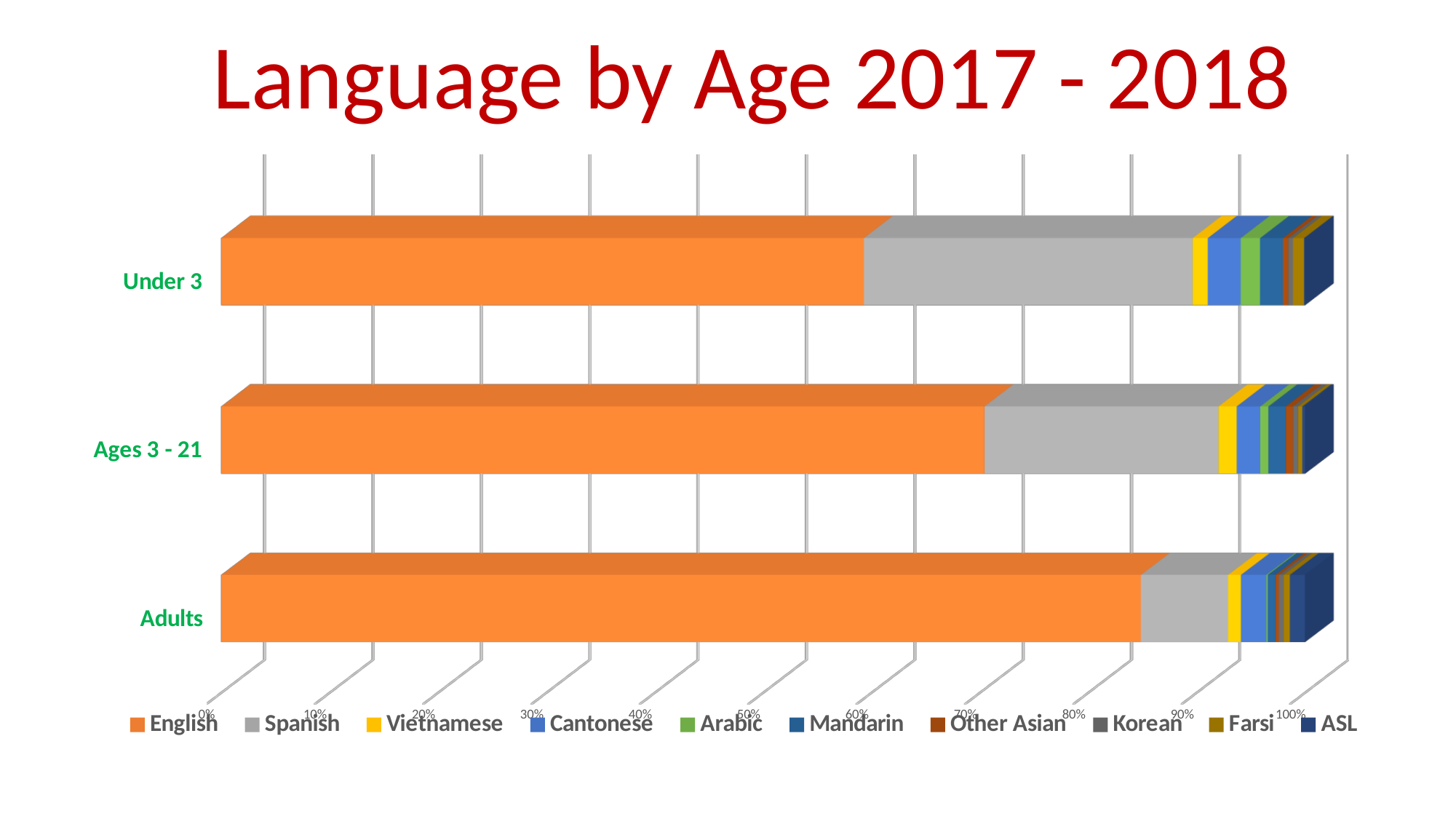
Which age group has the largest English share? Adults Is the English share for Ages 3 - 21 greater or less than 60%? greater Which age group has the smallest English share? Under 3 Which is larger, the Spanish share for Under 3 or the Spanish share for Adults? Under 3 What is the title of the chart? Language by Age 2017 - 2018 Is the English share for Under 3 greater or less than 70%? less Is the English share for Adults greater or less than 80%? greater How many language series does the legend list? 10 What kind of chart is shown on the slide? Stacked bar chart How many age groups are plotted on the chart? 3 Which age group has the largest Spanish share? Under 3